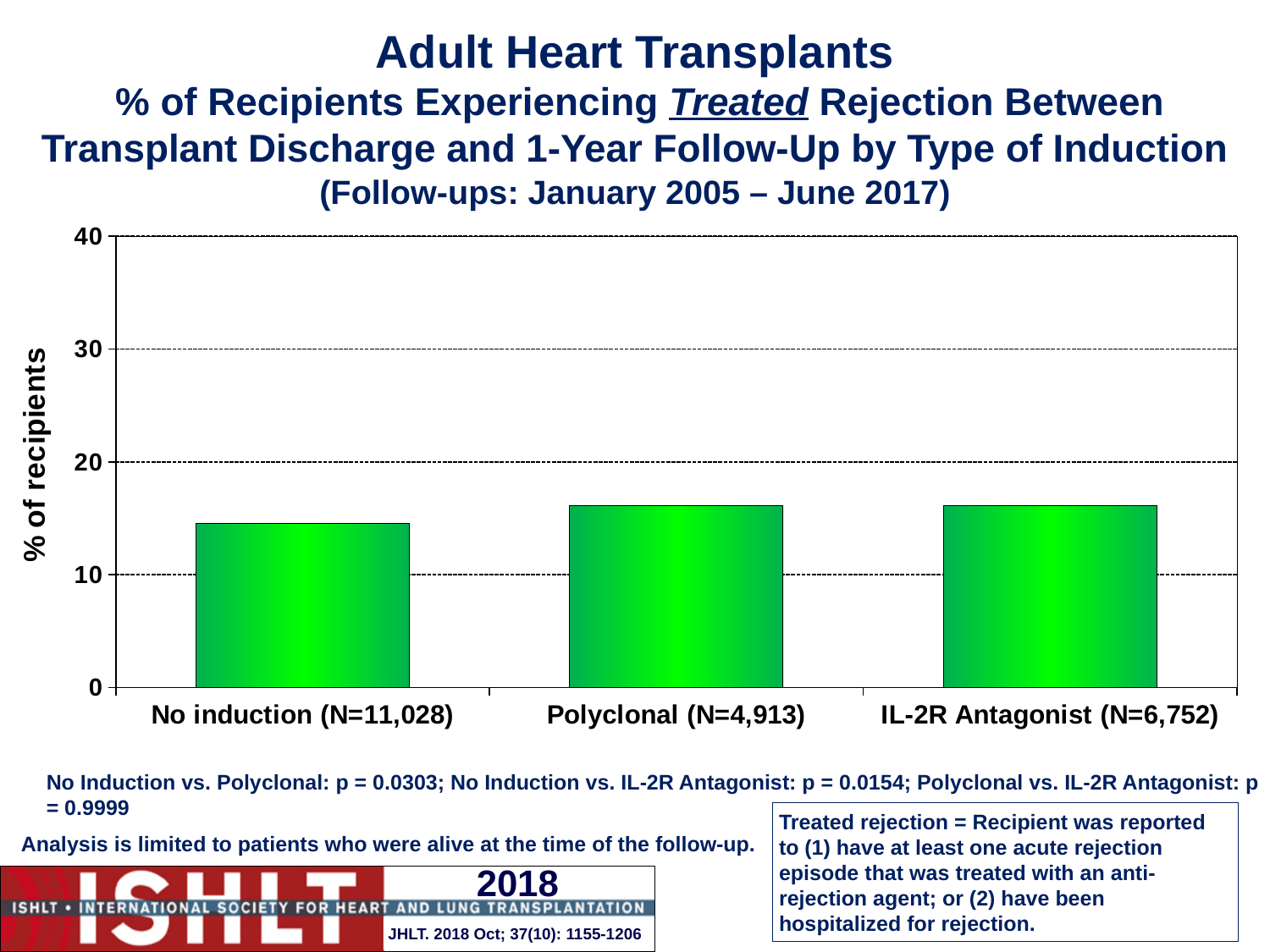
Is the value for No induction (N=11,028) greater or less than 20? less Is the value for IL-2R Antagonist (N=6,752) greater or less than 10? greater What kind of chart is shown on the slide? bar chart What is the maximum value shown on the vertical axis of the chart? 40 Is the value for No induction (N=11,028) greater or less than 10? greater How many induction-type categories are plotted on the chart? 3 Which is larger, the value for No induction (N=11,028) or the value for Polyclonal (N=4,913)? Polyclonal (N=4,913) Which induction type has the lowest % of recipients experiencing treated rejection? No induction (N=11,028) Which is larger, the value for IL-2R Antagonist (N=6,752) or the value for No induction (N=11,028)? IL-2R Antagonist (N=6,752) What is the label on the vertical axis of the chart? % of recipients